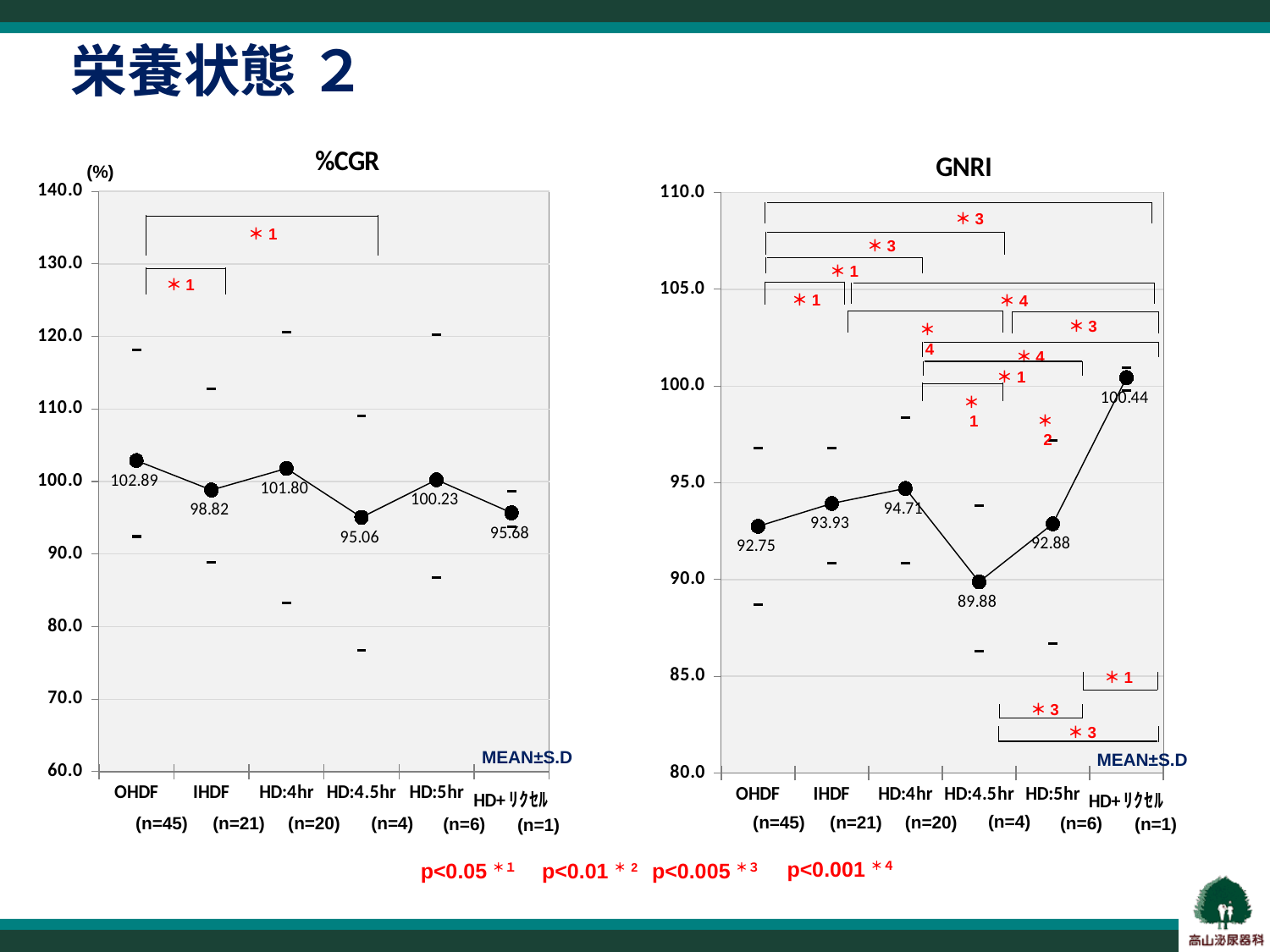
In the %CGR chart, is the mean value for HD:5hr greater or less than 100.0? greater What is the sample size (n) shown for the HD:4hr group in the %CGR chart? n=20 In the GNRI chart, what is the mean value for IHDF? 93.93 In the GNRI chart, what is the mean value for HD+リクセル? 100.44 In the GNRI chart, which is larger, the mean value for HD:4hr or HD:5hr? HD:4hr In the %CGR chart, what is the mean value for OHDF? 102.89 In the GNRI chart, which group has the highest mean value? HD+リクセル How many groups are plotted along the x axis of the GNRI chart? 6 In the %CGR chart, what is the mean value for HD:4.5hr? 95.06 In the %CGR chart, which group has the highest mean value? OHDF In the %CGR chart, what is the difference between the mean values for OHDF and IHDF? 4.07 In the GNRI chart, which group has the lowest mean value? HD:4.5hr